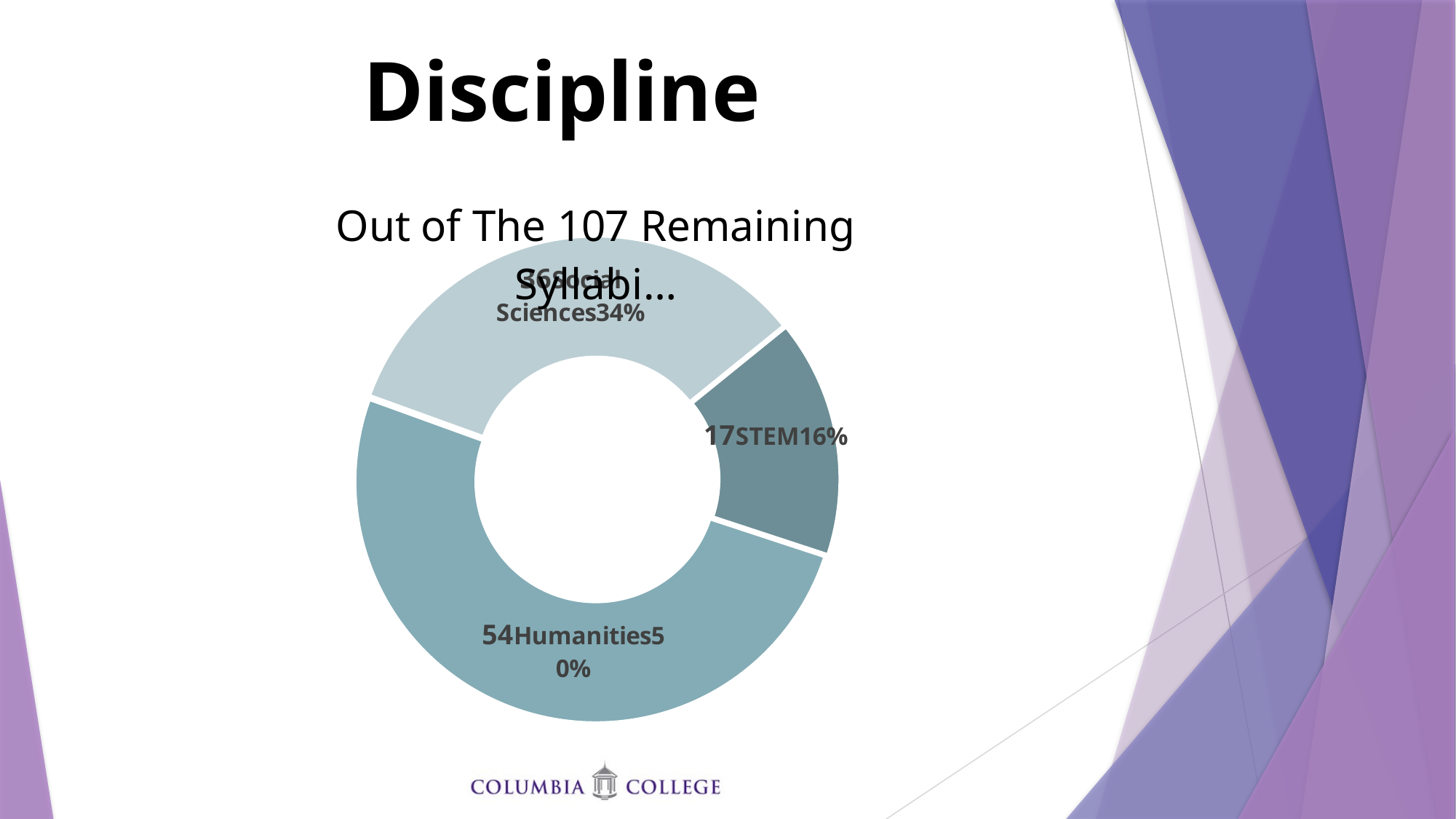
How many more syllabi are in Humanities than in STEM? 37 What percentage of the syllabi are Social Sciences? 34% What kind of chart is shown on the slide? Doughnut (pie) chart Which has more syllabi, Humanities or STEM? Humanities Which discipline has the largest share of the syllabi? Humanities How many syllabi are in the Humanities category? 54 What percentage of the syllabi are STEM? 16% What percentage of the syllabi are Humanities? 50% How many slices does the doughnut chart have? 3 How many syllabi are in the STEM category? 17 Which discipline has the smallest share of the syllabi? STEM What is the title of the chart? Out of The 107 Remaining Syllabi...